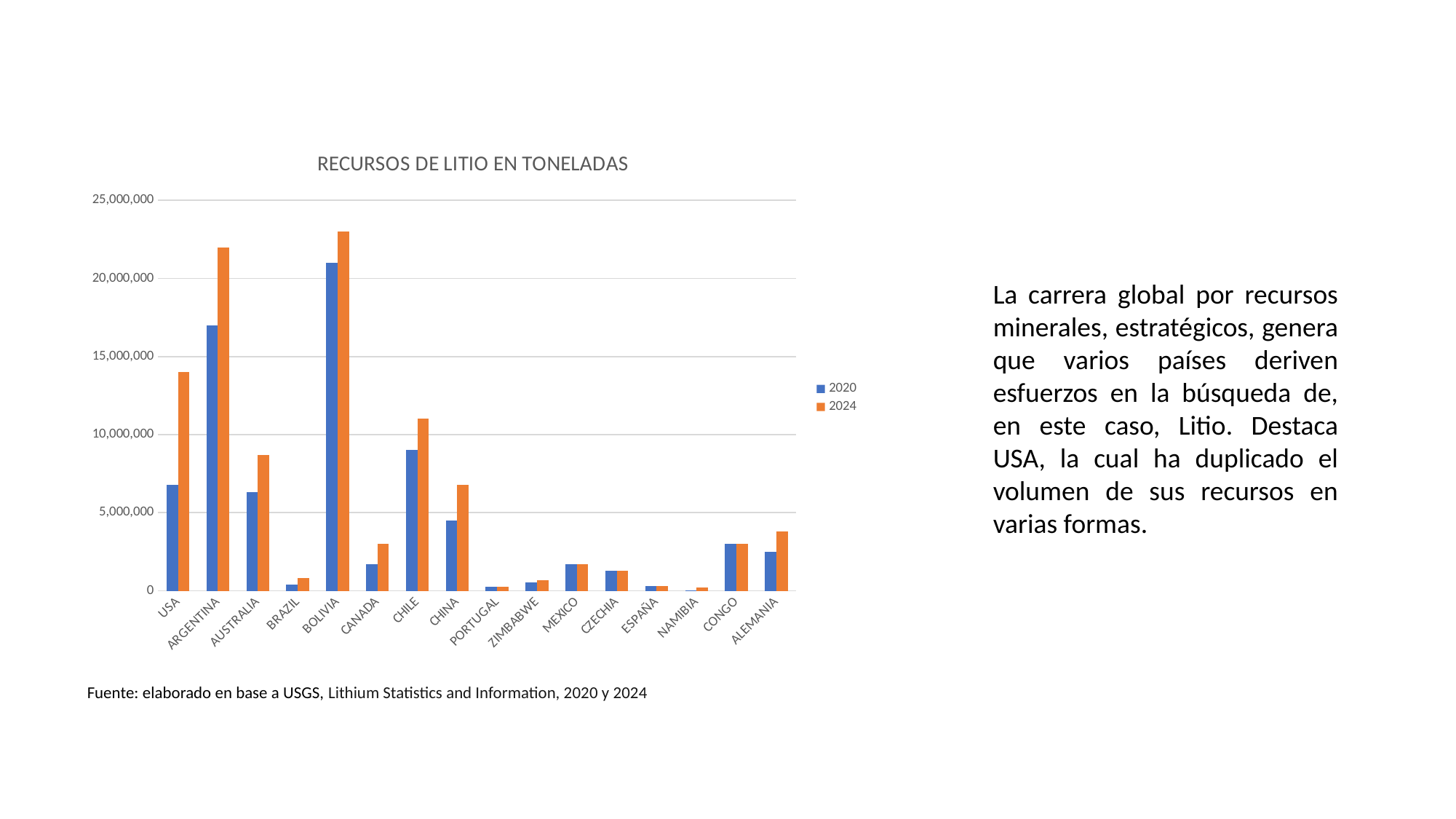
Which country has the highest value for 2020? BOLIVIA Is the 2024 value for USA greater or less than 15,000,000? less Is the 2020 value for ARGENTINA greater or less than 15,000,000? greater How many countries are shown on the x axis of the chart? 16 Which is larger, the 2024 value for USA or the 2024 value for ARGENTINA? ARGENTINA Which country has the lowest value for 2020? NAMIBIA Which country has the highest value for 2024? BOLIVIA How many series does the legend list? 2 What type of chart is shown on the slide? Bar chart Which is larger, the 2020 value for CHILE or the 2020 value for AUSTRALIA? CHILE What is the title of the chart? RECURSOS DE LITIO EN TONELADAS Is the 2024 value for BOLIVIA greater or less than 20,000,000? greater